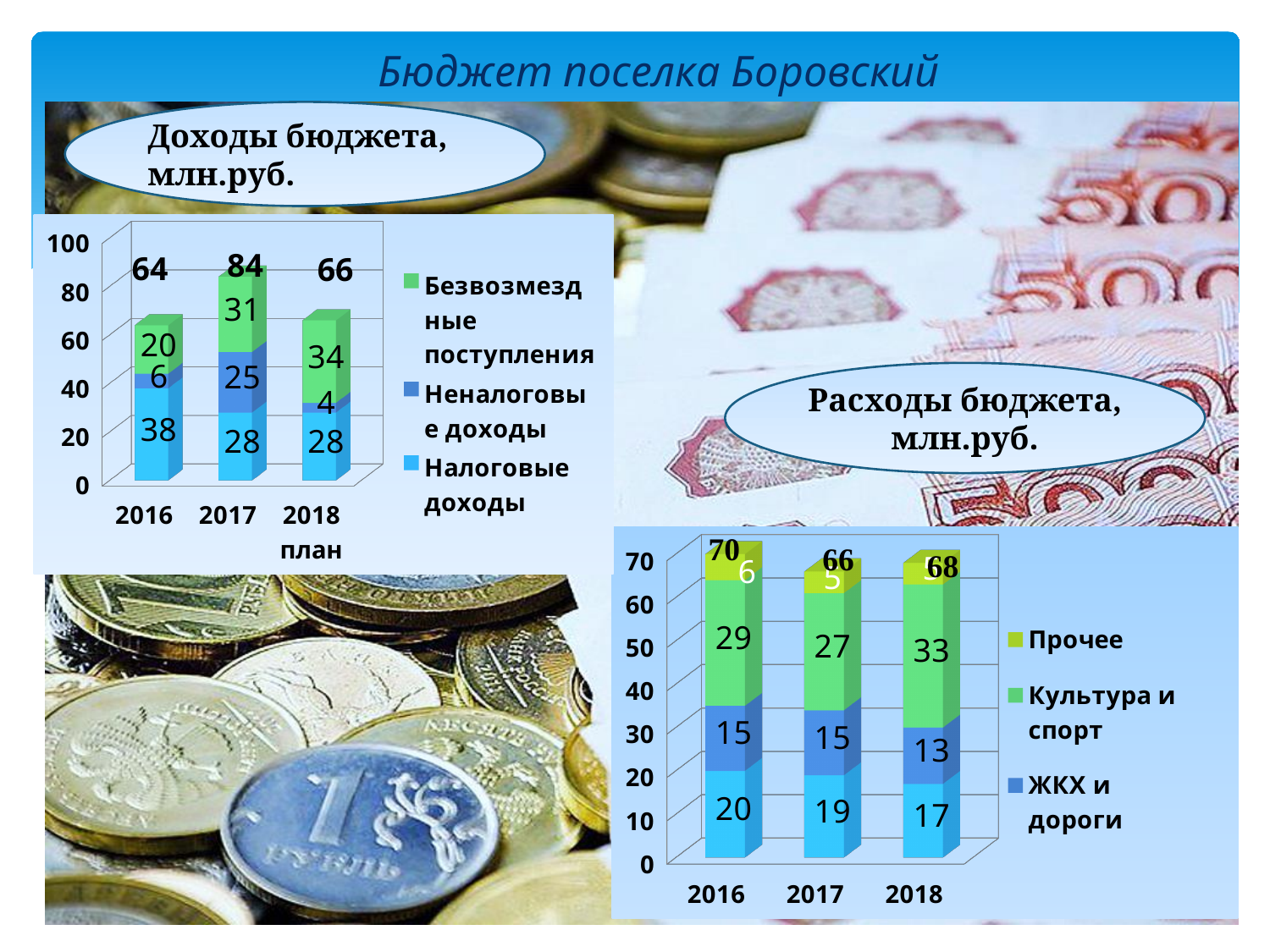
In the chart 'Доходы бюджета, млн.руб.', what is the total of the stacked bar for 2017? 84 In the chart 'Расходы бюджета, млн.руб.', which year has the lowest total expenditure? 2017 In the chart 'Доходы бюджета, млн.руб.', what is the difference between Безвозмездные поступления in 2018 план and in 2016? 14 In the chart 'Доходы бюджета, млн.руб.', what is the value of Неналоговые доходы for 2018 план? 4 In the chart 'Доходы бюджета, млн.руб.', how many series does the legend list? 3 In the chart 'Расходы бюджета, млн.руб.', what is the value of ЖКХ и дороги for 2017? 15 In the chart 'Расходы бюджета, млн.руб.', is the value of Прочее larger in 2016 or in 2017? 2016 What kind of chart is 'Расходы бюджета, млн.руб.'? Stacked bar chart In the chart 'Расходы бюджета, млн.руб.', what is the value of Культура и спорт for 2018? 33 In the chart 'Доходы бюджета, млн.руб.', which year has the highest total income? 2017 In the chart 'Доходы бюджета, млн.руб.', what is the value of Налоговые доходы for 2016? 38 In the chart 'Доходы бюджета, млн.руб.', what is the value of Безвозмездные поступления for 2017? 31